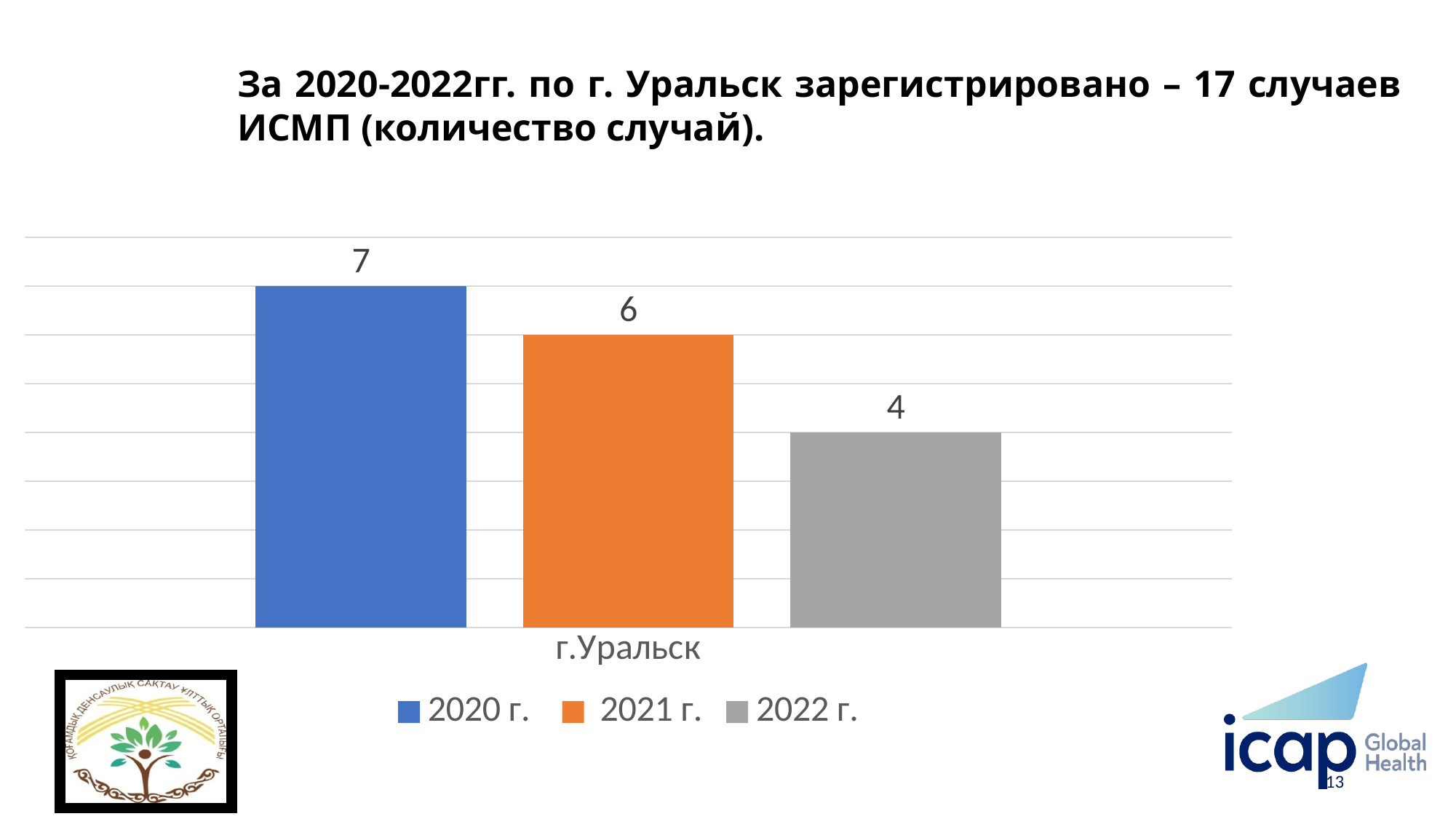
What is the value for 2020 г. in the chart? 7 Which is larger, the value for 2020 г. or the value for 2021 г.? 2020 г. Do the values rise or fall from 2020 г. to 2022 г.? fall Which year has the highest value in the chart? 2020 г. What is the category label shown on the x axis of the chart? г.Уральск What is the difference between the values for 2020 г. and 2022 г.? 3 How many series does the legend list? 3 What is the value for 2022 г. in the chart? 4 What kind of chart is shown on the slide? bar chart Which year has the lowest value in the chart? 2022 г. What is the difference between the values for 2021 г. and 2022 г.? 2 What is the value for 2021 г. in the chart? 6